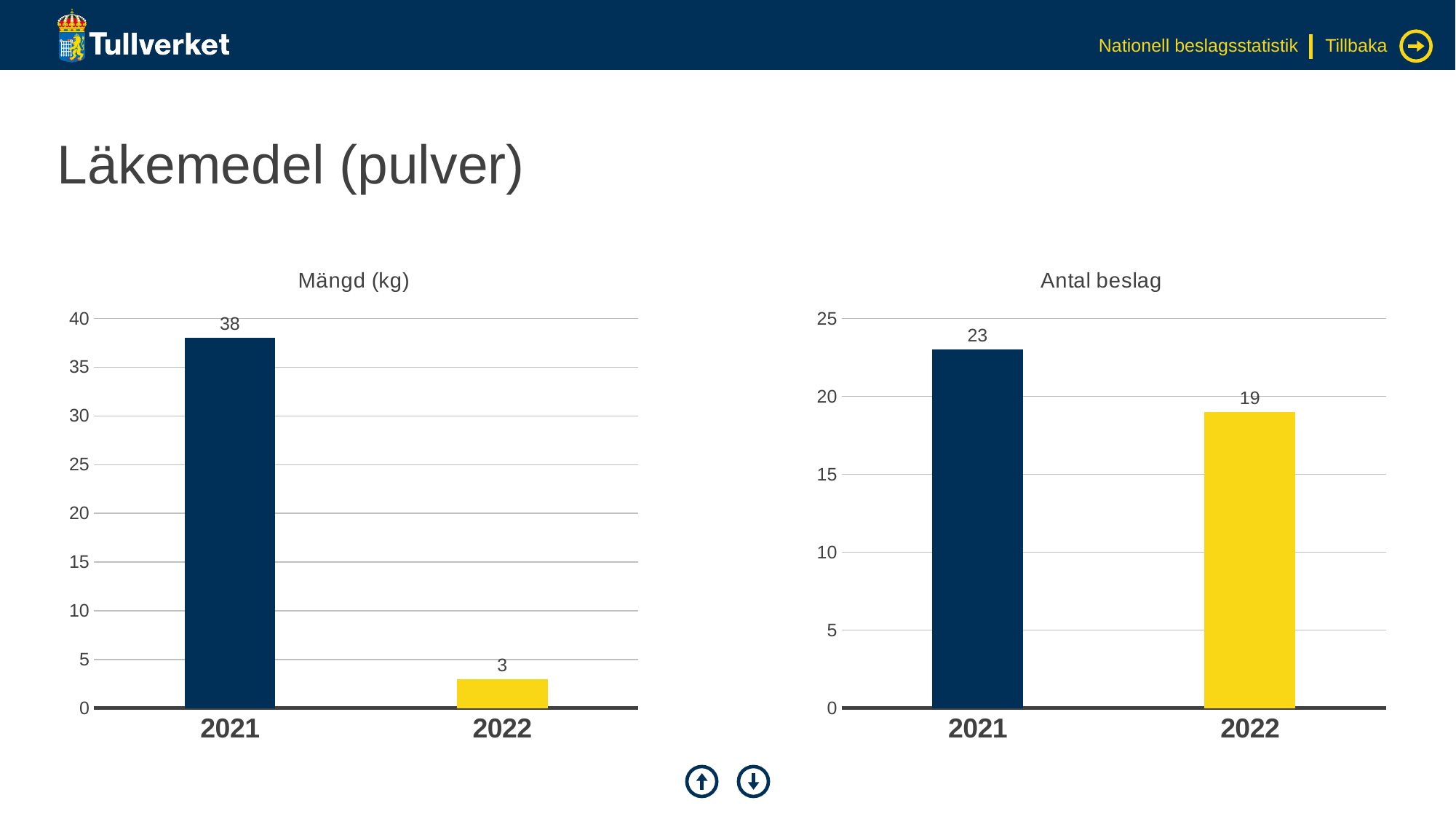
In the 'Mängd (kg)' chart, what is the value for 2021? 38 In the 'Antal beslag' chart, is the value for 2022 greater or less than 20? less In the 'Antal beslag' chart, what is the difference between the 2021 and 2022 values? 4 In the 'Antal beslag' chart, which year has the lowest value? 2022 In the 'Mängd (kg)' chart, which year has the highest value? 2021 In the 'Antal beslag' chart, is the value for 2021 or 2022 larger? 2021 What kind of chart is the 'Antal beslag' chart? bar chart In the 'Antal beslag' chart, what is the value for 2022? 19 In the 'Antal beslag' chart, what is the value for 2021? 23 In the 'Mängd (kg)' chart, what is the difference between the 2021 and 2022 values? 35 How many categories are shown on the x axis of the 'Mängd (kg)' chart? 2 In the 'Mängd (kg)' chart, what is the value for 2022? 3